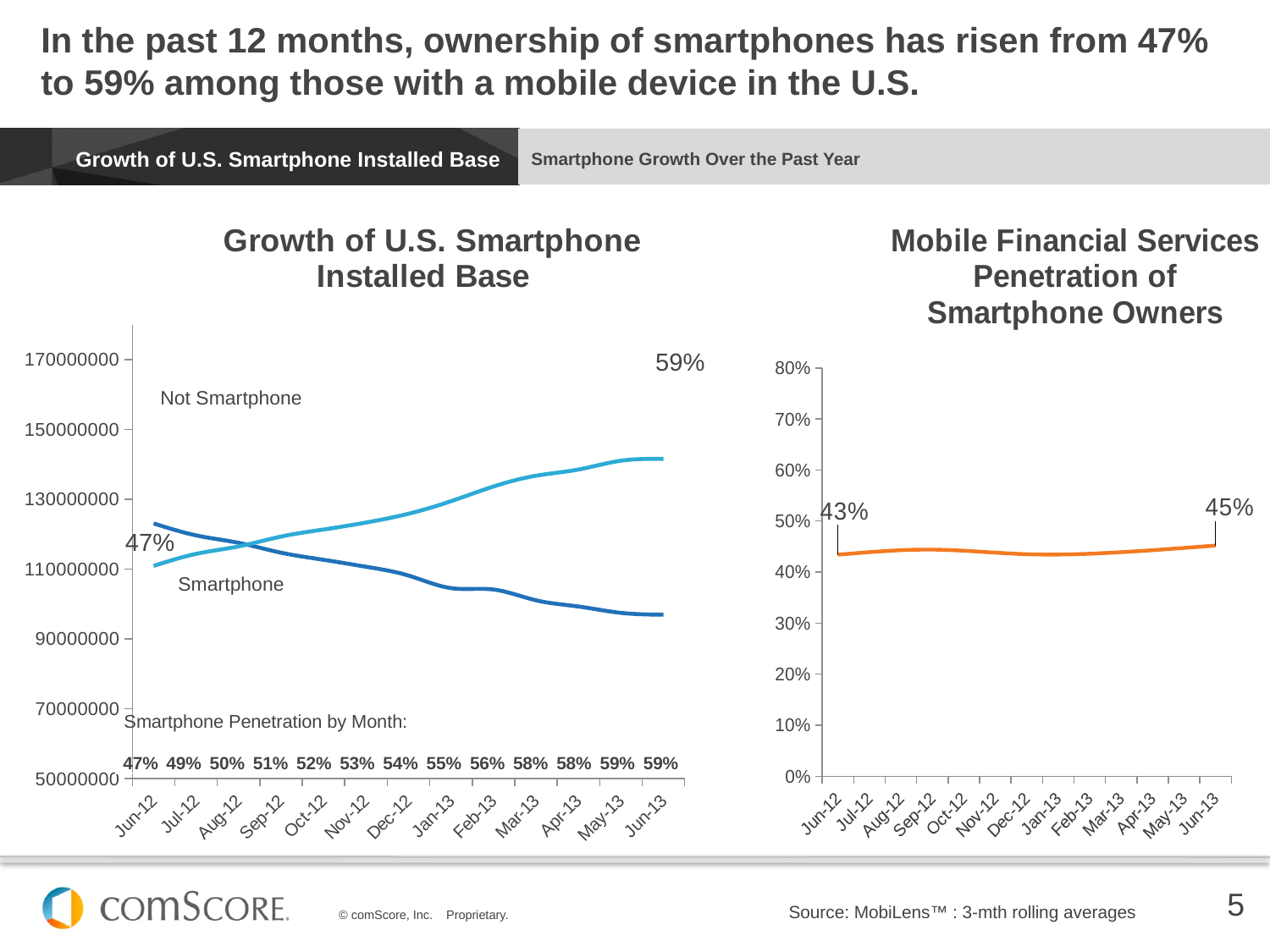
In the 'Growth of U.S. Smartphone Installed Base' chart, does the Not Smartphone line rise or fall from Jun-12 to Jun-13? Fall In the 'Growth of U.S. Smartphone Installed Base' chart, what is the smartphone penetration for Mar-13? 58% In the 'Growth of U.S. Smartphone Installed Base' chart, how many months are shown on the x axis? 13 In the 'Growth of U.S. Smartphone Installed Base' chart, by how many percentage points did smartphone penetration rise from Jun-12 to Jun-13? 12 percentage points In the 'Growth of U.S. Smartphone Installed Base' chart, which line is higher in Jun-13, Smartphone or Not Smartphone? Smartphone In the 'Growth of U.S. Smartphone Installed Base' chart, is the Not Smartphone value for Jun-13 greater or less than 110000000? less What kind of chart is the 'Growth of U.S. Smartphone Installed Base' chart? Line chart In the 'Growth of U.S. Smartphone Installed Base' chart, what is the smartphone penetration for Jun-13? 59% In the 'Mobile Financial Services Penetration of Smartphone Owners' chart, what is the value for Jun-12? 43% In the 'Mobile Financial Services Penetration of Smartphone Owners' chart, what is the value for Jun-13? 45% In the 'Growth of U.S. Smartphone Installed Base' chart, what is the smartphone penetration for Jun-12? 47% In the 'Growth of U.S. Smartphone Installed Base' chart, does the Smartphone line rise or fall from Jun-12 to Jun-13? Rise